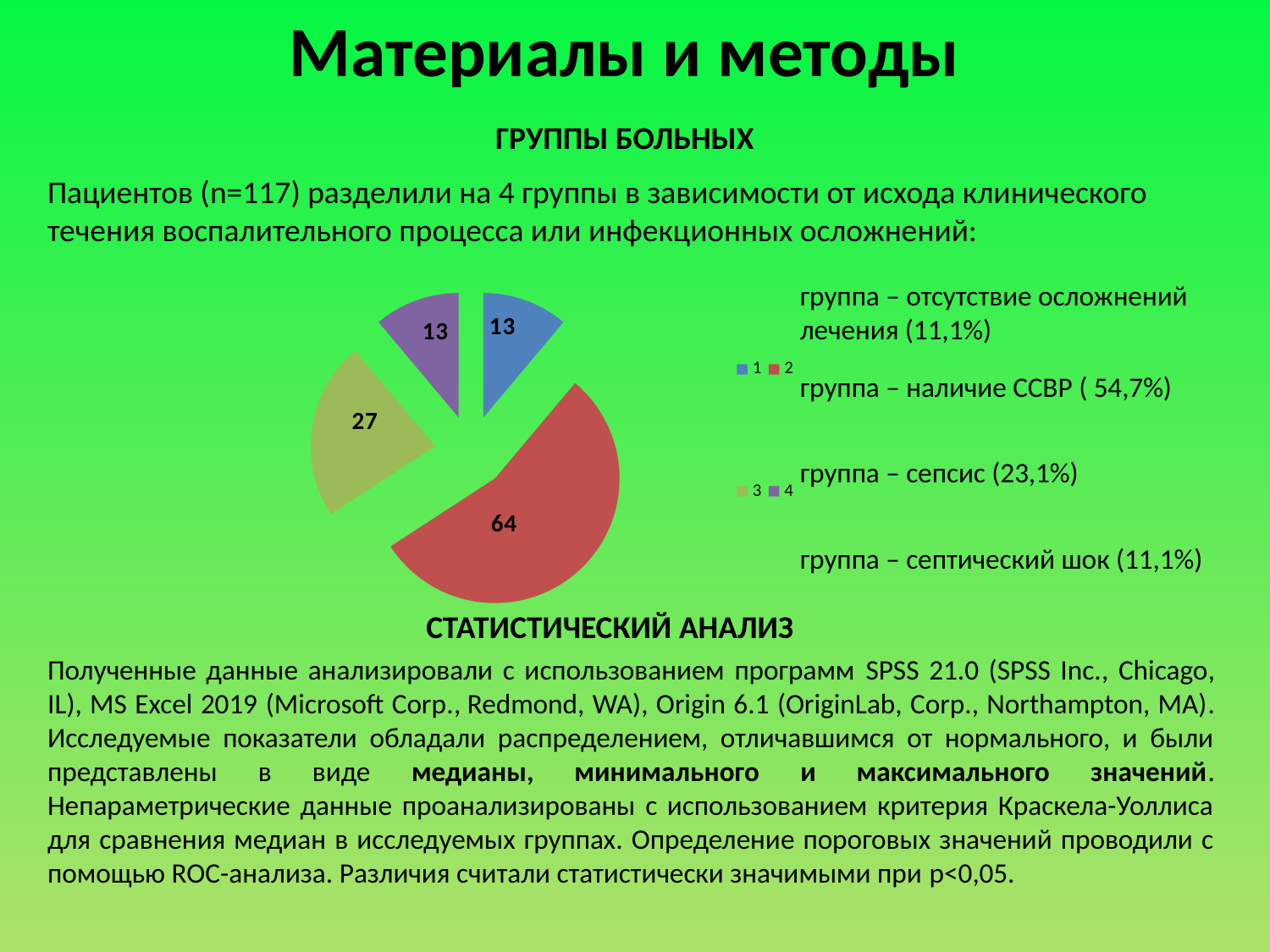
What colour is the slice for group 4 in the pie chart? purple How many slices does the pie chart have? 4 What is the value of the green slice (group 3) in the pie chart? 27 Which is larger in the pie chart: the green slice (group 3) or the purple slice (group 4)? group 3 What share of the pie does the red slice (group 2) represent? 54,7% What is the value of the blue slice (group 1) in the pie chart? 13 Which group has the largest slice in the pie chart? 2 What kind of chart is shown on the slide? pie chart What is the difference between the values of the red slice (64) and the green slice (27)? 37 What is the value of the red slice (group 2) in the pie chart? 64 What is the total of all slices in the pie chart? 117 How many entries does the legend of the pie chart list? 4